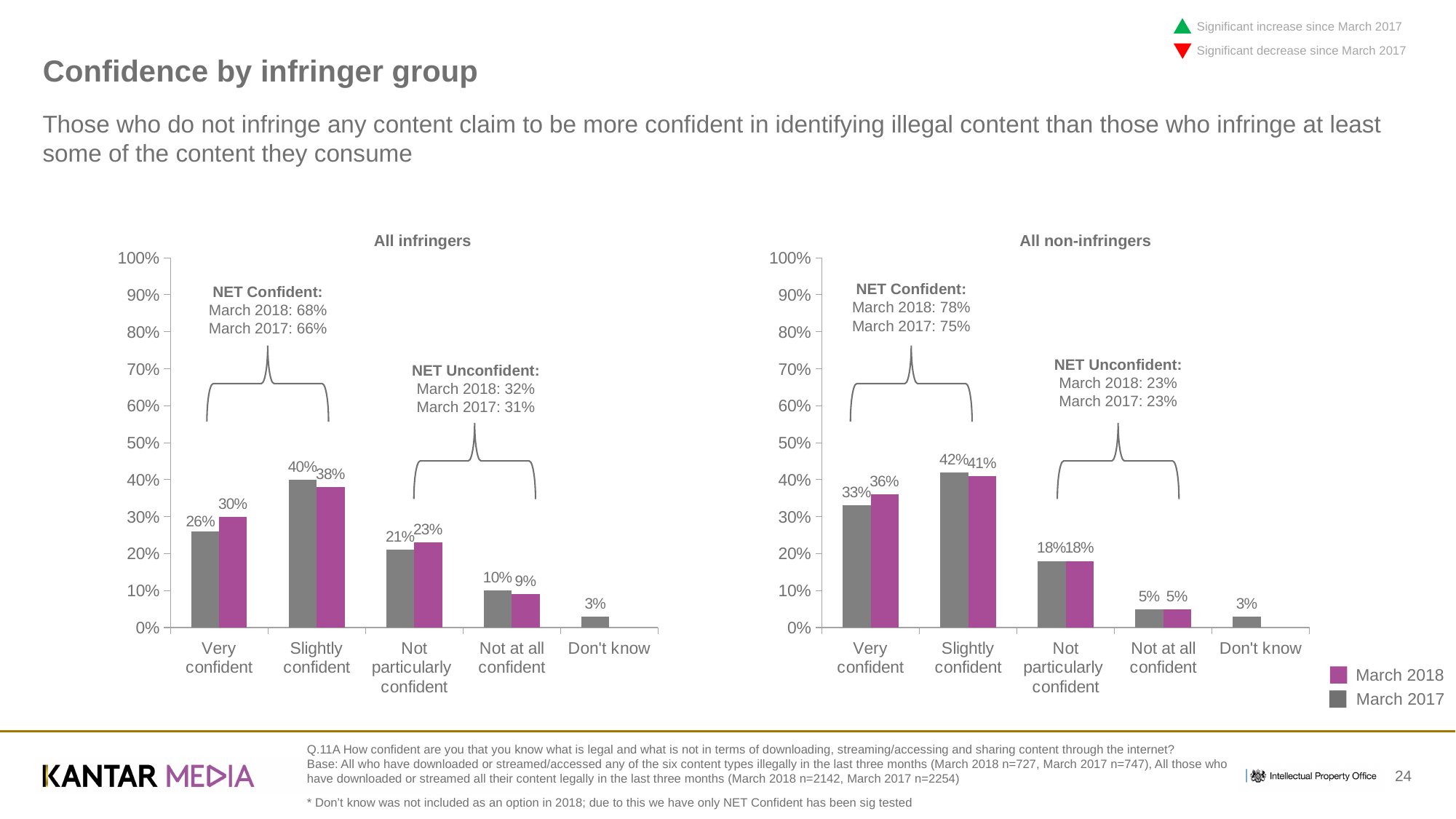
In the 'All infringers' chart, what is the March 2017 value for 'Slightly confident'? 40% In the 'All infringers' chart, which category has the highest March 2018 value? Slightly confident How many series does the legend list? 2 In the 'All infringers' chart, what is the March 2018 value for 'Very confident'? 30% In the 'All non-infringers' chart, what is the March 2017 value for 'Not at all confident'? 5% In the 'All non-infringers' chart, which is larger for 'Slightly confident': the March 2017 value or the March 2018 value? March 2017 According to the annotation on the 'All non-infringers' chart, what was NET Confident in March 2018? 78% In the 'All non-infringers' chart, which category has the lowest March 2017 value? Don't know What type of chart is the 'All non-infringers' chart? Bar chart How many categories are shown on the x axis of the 'All infringers' chart? 5 In the 'All infringers' chart, what is the difference between the March 2018 and March 2017 values for 'Very confident'? 4% In the 'All non-infringers' chart, what is the March 2018 value for 'Very confident'? 36%